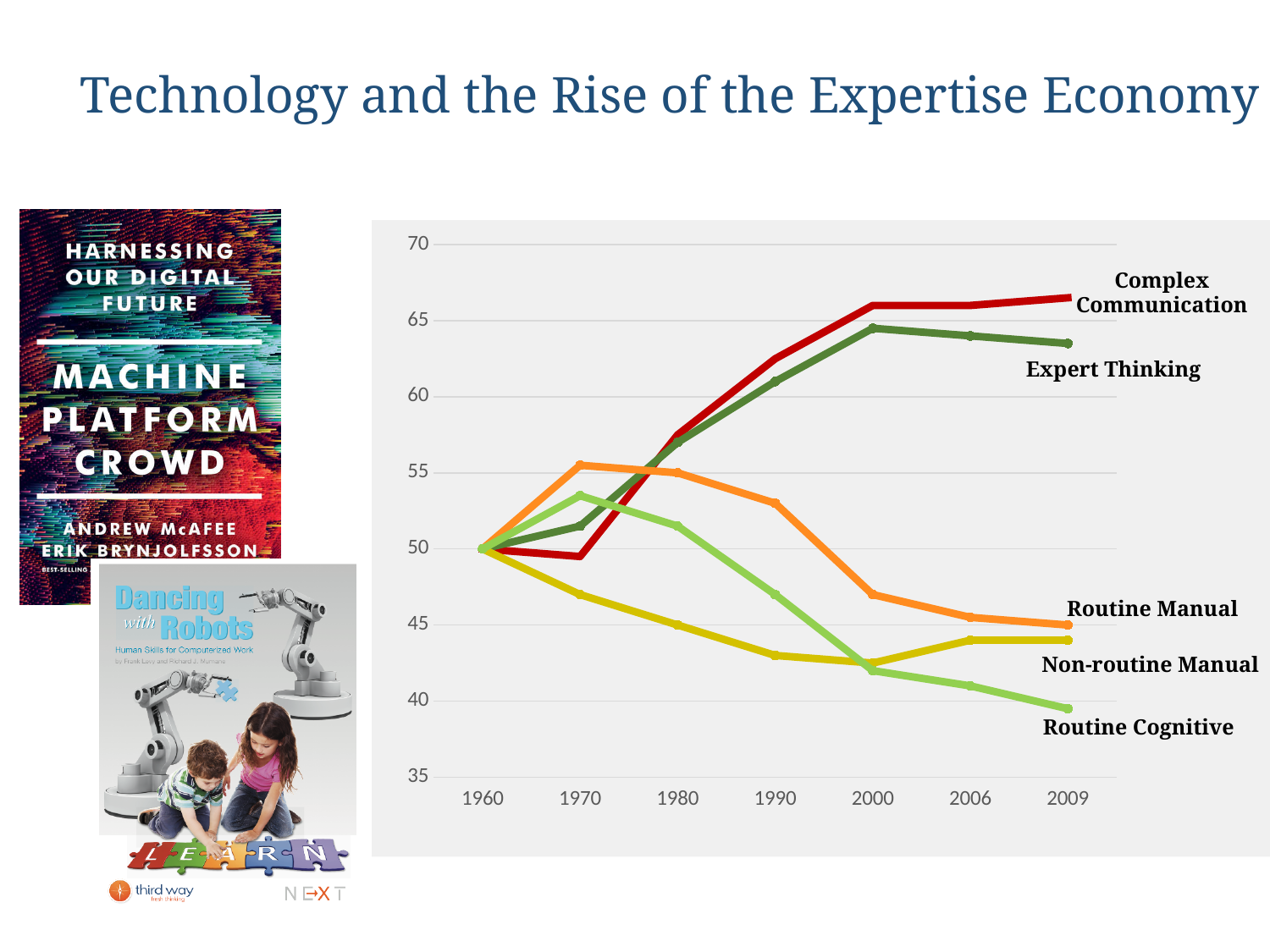
Which is larger in 2000, Routine Manual or Routine Cognitive? Routine Manual What is the value of all the series in 1960? 50 How many years are shown on the x axis of the chart? 7 Does the Routine Cognitive series rise or fall from 1980 to 2009? fall Which series has the lowest value in 2009? Routine Cognitive How many series are plotted on the chart? 5 Is the value for Expert Thinking in 2000 greater or less than 60? greater Is the value for Routine Manual in 2000 greater or less than 50? less Is the value for Complex Communication in 2009 greater or less than 65? greater Which series has the highest value in 1970? Routine Manual Which series has the highest value in 2009? Complex Communication What kind of chart is shown on the slide? line chart